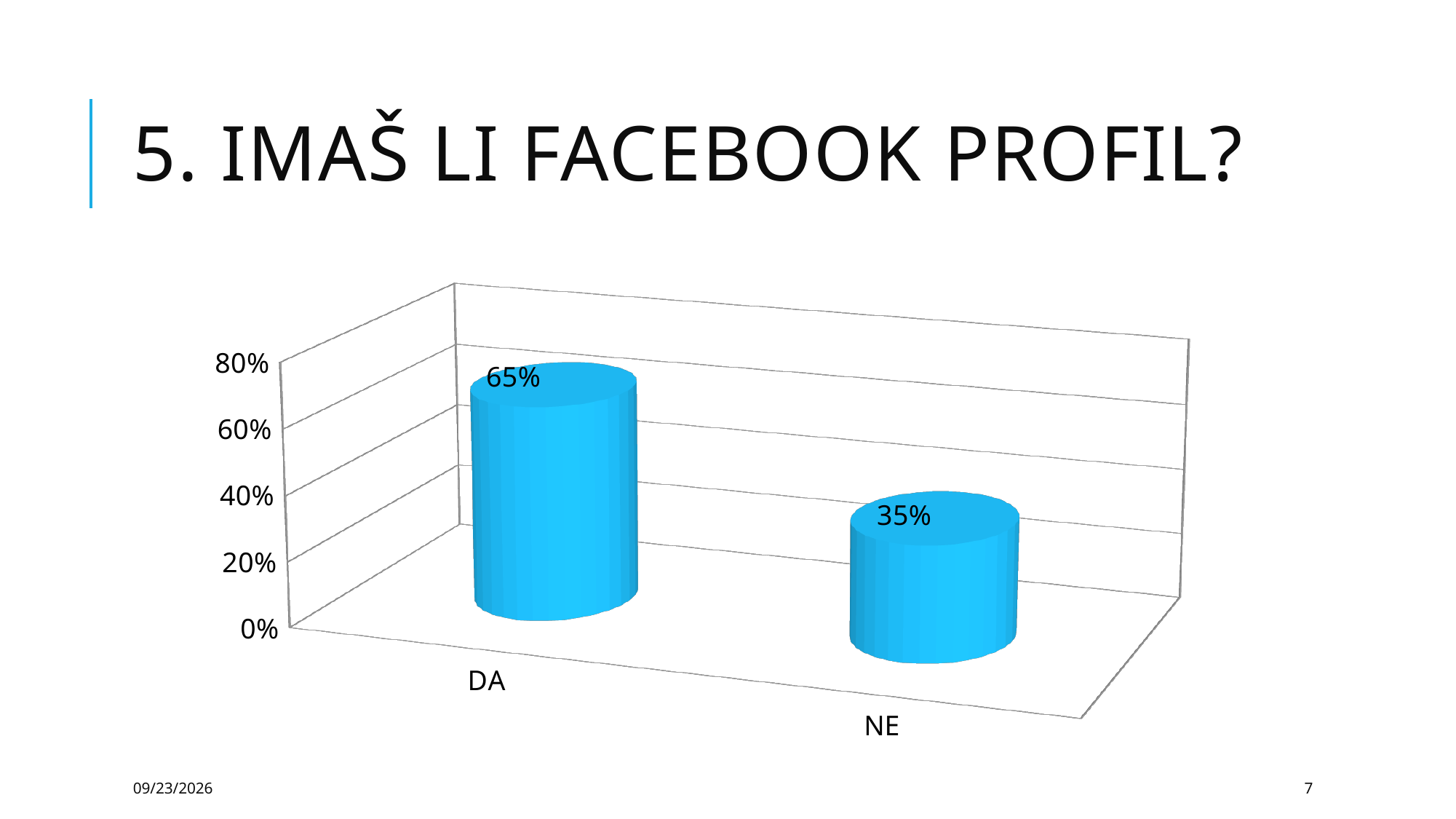
What is the highest value shown on the vertical axis? 80% Is the value for NE greater or less than 40%? less What is the value for DA? 65% How many categories are shown on the x axis? 2 What kind of chart is shown on the slide? bar chart What is the title of the slide above the chart? 5. IMAŠ LI FACEBOOK PROFIL? What is the difference between the values for DA and NE? 30% Which category has the highest value? DA Is the value for DA greater or less than 60%? greater Which is larger, the value for DA or the value for NE? DA What is the value for NE? 35% Which category has the lowest value? NE